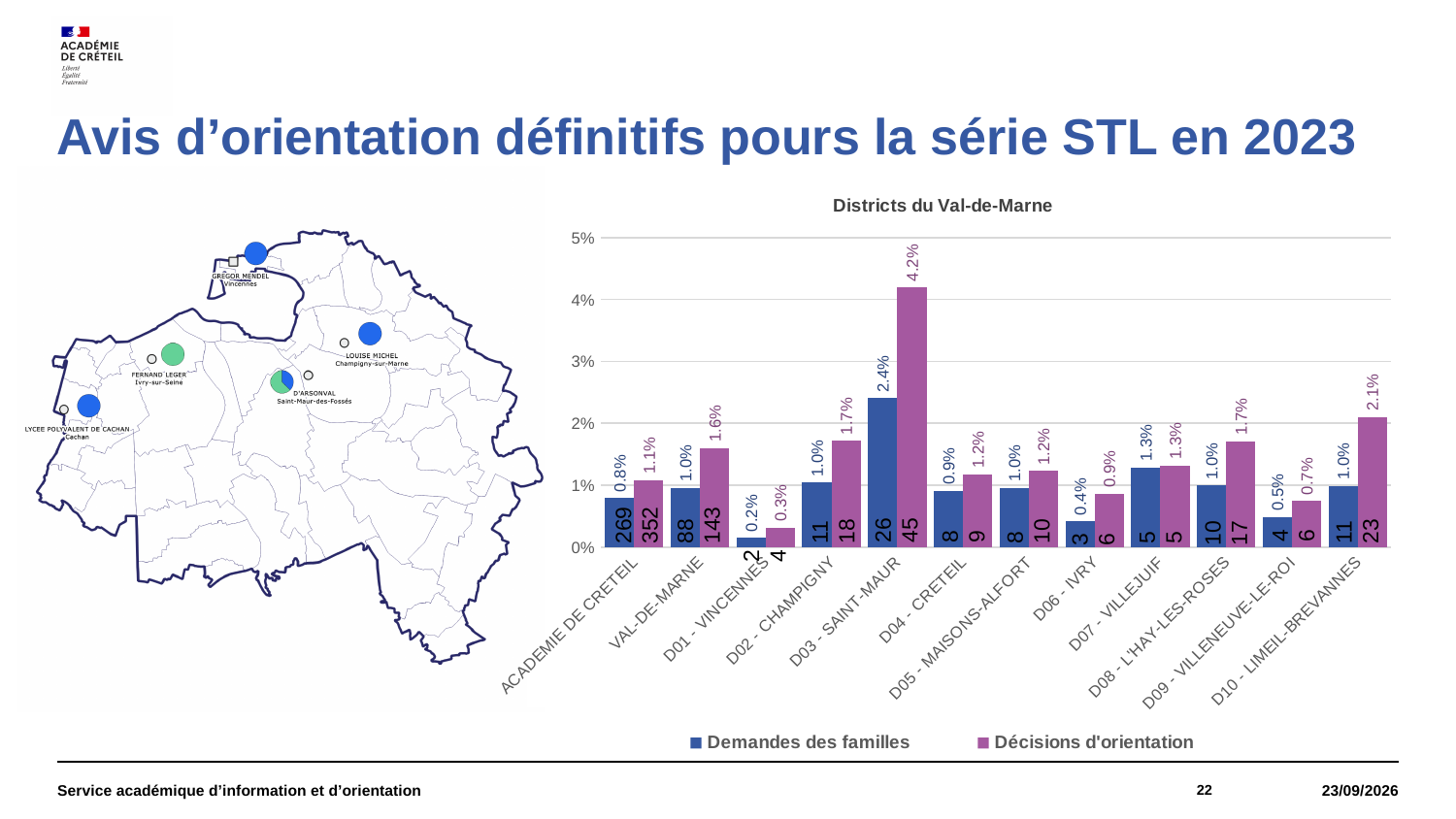
How many categories are shown on the x axis of the 'Districts du Val-de-Marne' chart? 12 What count is printed inside the 'Décisions d'orientation' bar for VAL-DE-MARNE? 143 Is the 'Décisions d'orientation' value for D03 - SAINT-MAUR greater or less than 4%? greater Which category has the highest 'Décisions d'orientation' percentage? D03 - SAINT-MAUR How many series does the legend of the 'Districts du Val-de-Marne' chart list? 2 What is the 'Demandes des familles' percentage for ACADEMIE DE CRETEIL? 0.8% Which category has the lowest 'Demandes des familles' percentage? D01 - VINCENNES What type of chart is shown under the title 'Districts du Val-de-Marne'? bar chart Which colour represents 'Demandes des familles' in the 'Districts du Val-de-Marne' chart? blue Which is larger for D06 - IVRY: the 'Demandes des familles' percentage or the 'Décisions d'orientation' percentage? Décisions d'orientation What is the 'Décisions d'orientation' percentage for D03 - SAINT-MAUR? 4.2% What is the difference between the 'Décisions d'orientation' and 'Demandes des familles' percentages for D10 - LIMEIL-BREVANNES? 1.1%